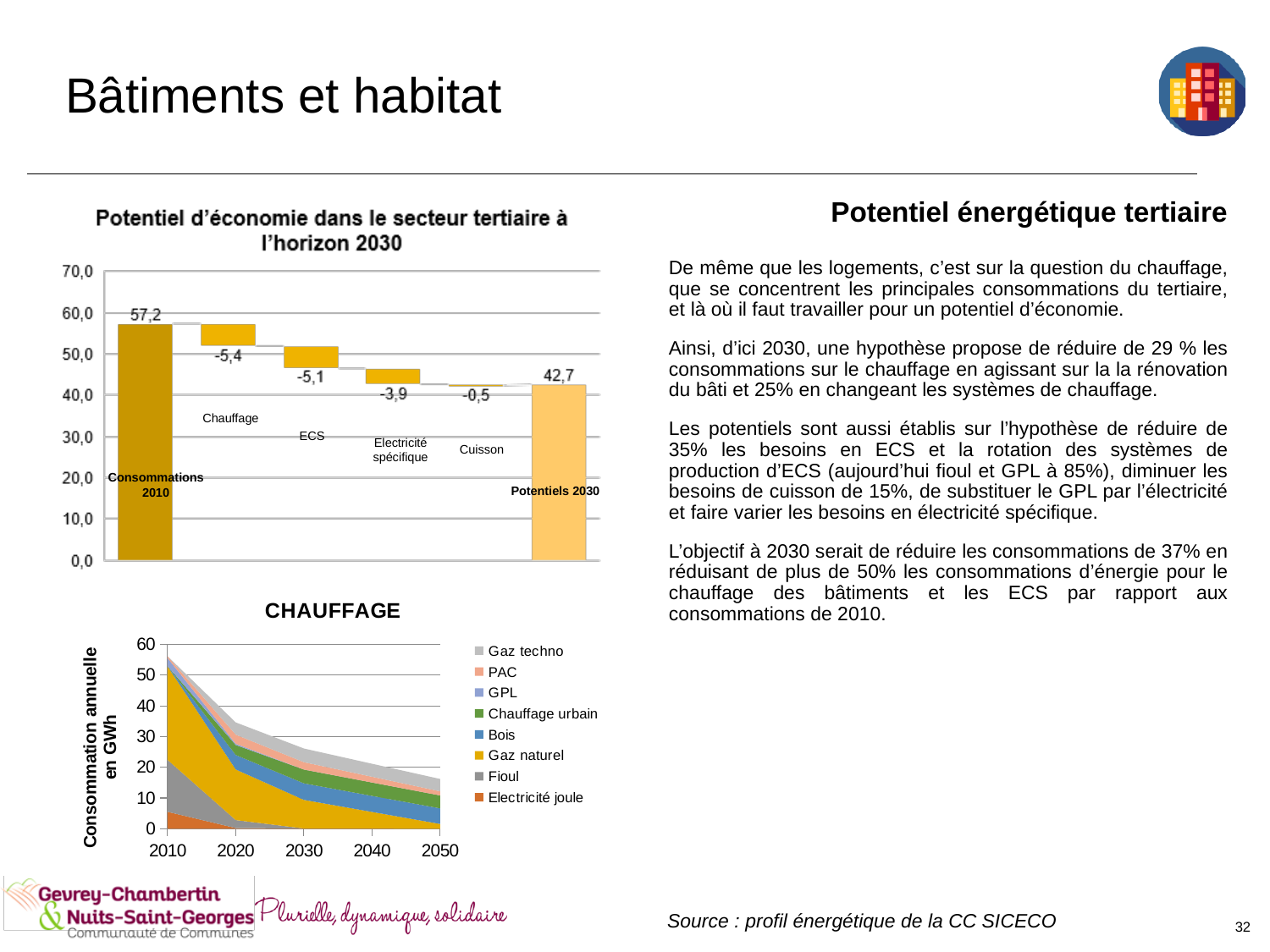
In the chart 'Potentiel d'économie dans le secteur tertiaire à l'horizon 2030', what reduction is shown for Cuisson? -0,5 In the chart 'Potentiel d'économie dans le secteur tertiaire à l'horizon 2030', what reduction is shown for Chauffage? -5,4 In the chart 'Potentiel d'économie dans le secteur tertiaire à l'horizon 2030', what is the value for Potentiels 2030? 42,7 In the chart 'Potentiel d'économie dans le secteur tertiaire à l'horizon 2030', which reduction step is the smallest in magnitude? Cuisson How many series does the legend of the CHAUFFAGE chart list? 8 In the chart 'Potentiel d'économie dans le secteur tertiaire à l'horizon 2030', which reduction step is the largest in magnitude? Chauffage In the chart 'Potentiel d'économie dans le secteur tertiaire à l'horizon 2030', what is the value for Consommations 2010? 57,2 In the CHAUFFAGE chart, is the total consumption in 2010 greater or less than 50 GWh? greater In the chart 'Potentiel d'économie dans le secteur tertiaire à l'horizon 2030', is the reduction for ECS larger in magnitude than the reduction for Electricité spécifique? Yes In the chart 'Potentiel d'économie dans le secteur tertiaire à l'horizon 2030', what is the difference between Consommations 2010 and Potentiels 2030? 14,5 What type of chart is the CHAUFFAGE chart? Stacked area chart In the CHAUFFAGE chart, does total annual consumption rise or fall from 2010 to 2050? Fall